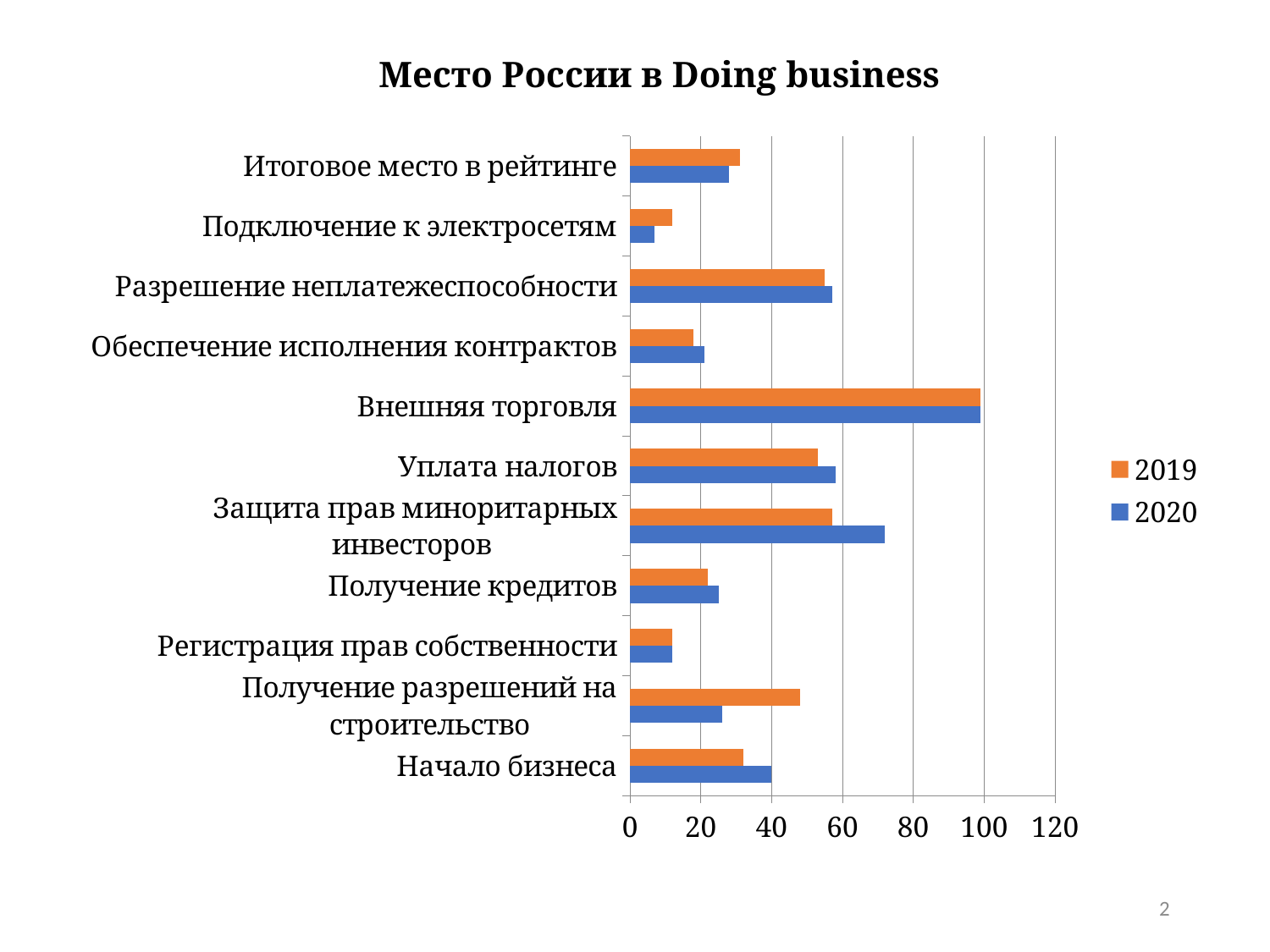
For Получение разрешений на строительство, which year has the larger value, 2019 or 2020? 2019 Is the 2019 value for Получение разрешений на строительство greater or less than 40? greater Which category has the highest value for 2020? Внешняя торговля Is the 2020 value for Начало бизнеса greater or less than 60? less What is the title of the chart? Место России в Doing business Which category has the lowest value for 2020? Подключение к электросетям How many categories are shown on the chart? 11 How many series does the legend list? 2 Which category has the highest value for 2019? Внешняя торговля Is the 2020 value for Защита прав миноритарных инвесторов greater or less than 60? greater What kind of chart is shown on the slide? bar chart For Защита прав миноритарных инвесторов, which year has the larger value, 2019 or 2020? 2020